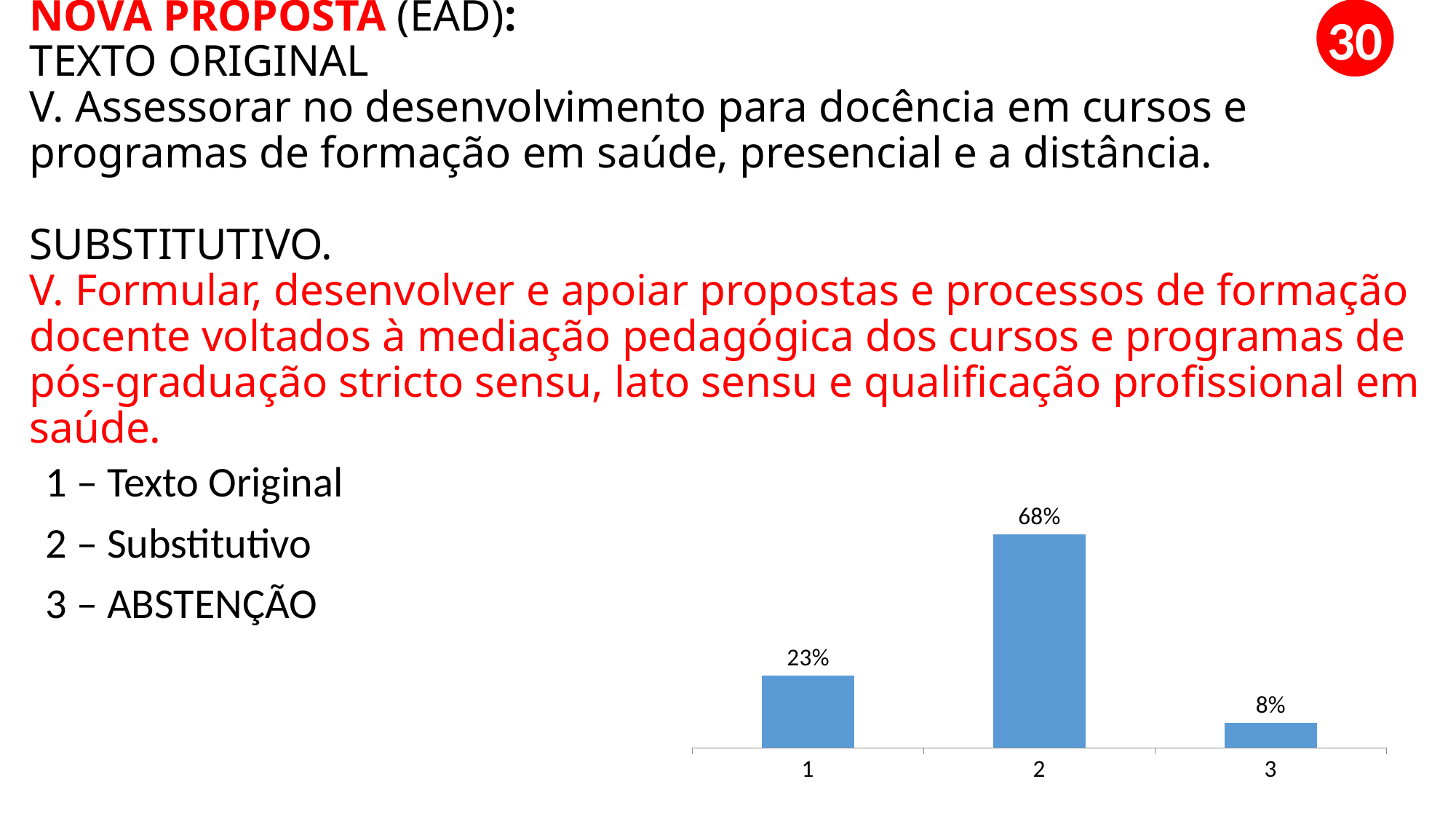
According to the slide's key, what does category 2 in the chart represent? Substitutivo Which category has the lowest value in the bar chart? 3 What is the value shown for category 3 in the bar chart? 8% What is the value shown for category 1 in the bar chart? 23% What colour are the bars in the chart? blue What is the difference between the values for category 1 and category 3? 15% How many categories are plotted in the bar chart? 3 What kind of chart is shown on the slide? bar chart What is the difference between the values for category 2 and category 1? 45% What is the value shown for category 2 in the bar chart? 68% Which category has the highest value in the bar chart? 2 Which is larger, the value for category 1 or the value for category 3? category 1